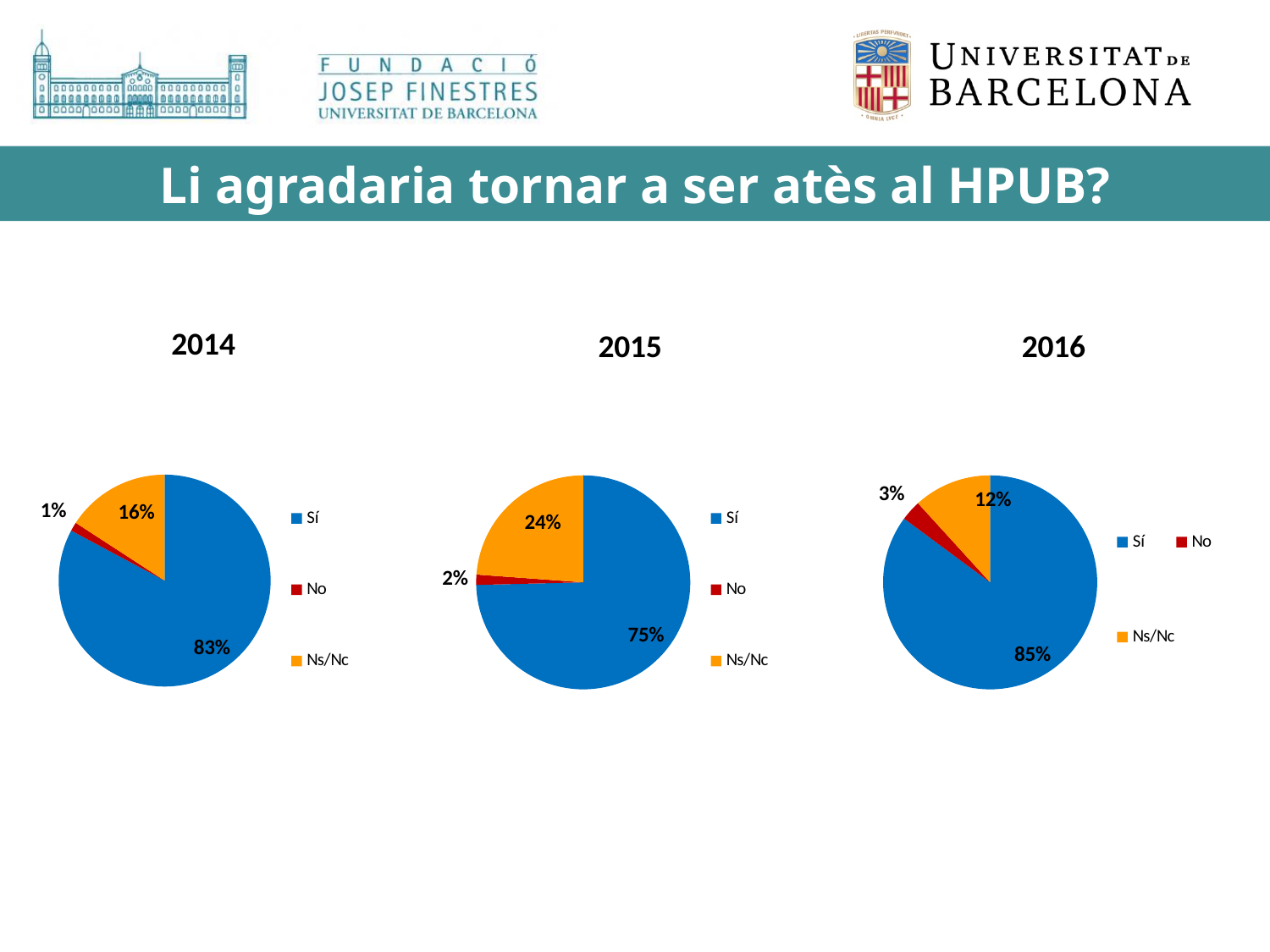
What kind of chart is the 2014 chart? Pie chart What colour represents Sí in the 2015 chart? Blue Is the Sí share larger in the 2015 chart or in the 2016 chart? 2016 How many entries does the legend of the 2016 chart list? 3 In the 2016 chart, which category has the largest slice? Sí In the 2014 chart, what percentage is shown for Sí? 83% In the 2016 chart, what percentage is shown for No? 3% In the 2014 chart, which category has the smallest slice? No How many slices does the 2015 chart have? 3 In the 2016 chart, what share of the pie does Ns/Nc represent? 12% In the 2015 chart, what percentage is shown for Ns/Nc? 24% In the 2015 chart, what is the difference between the Sí and Ns/Nc percentages? 51%